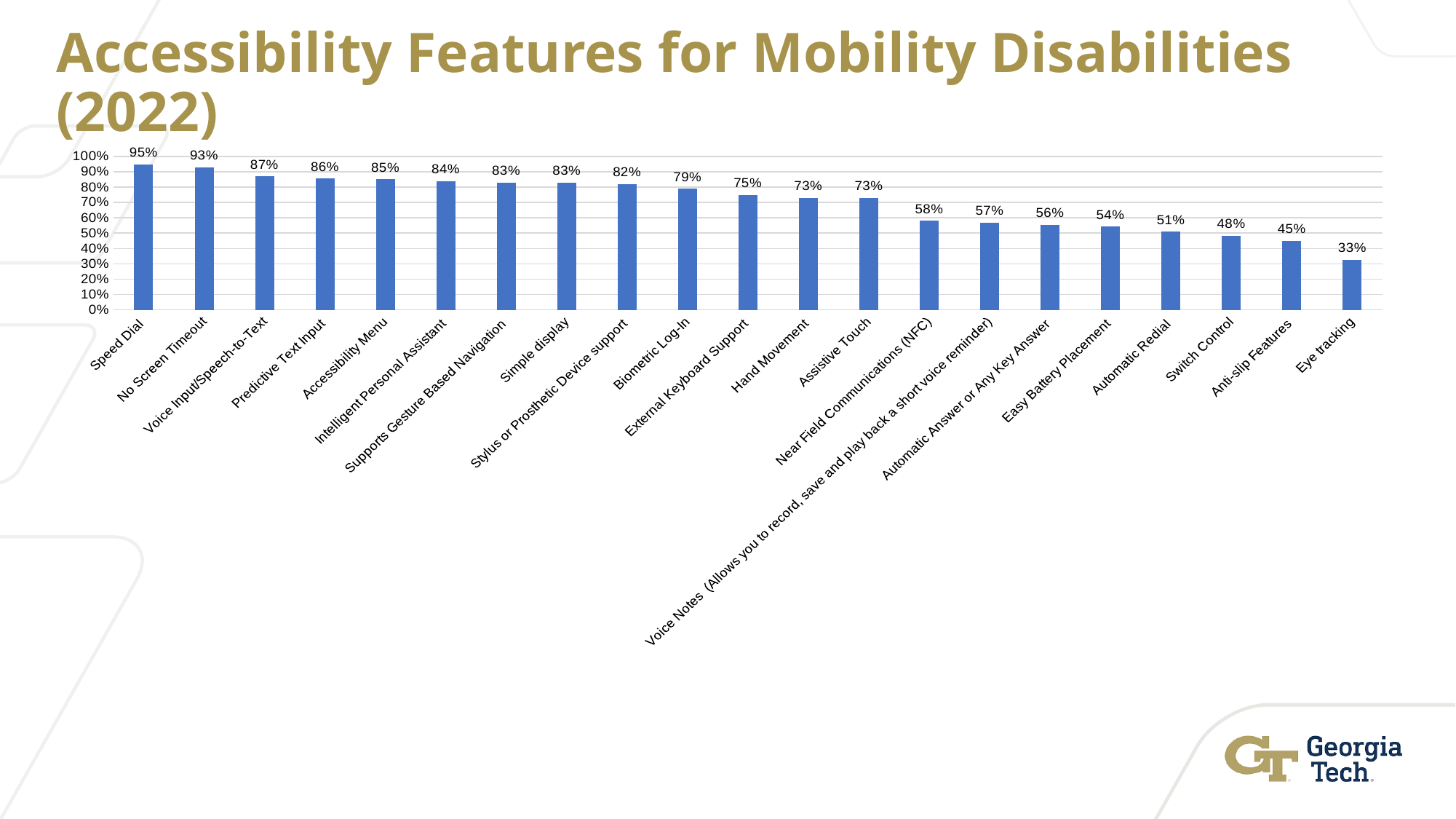
What kind of chart is shown on the slide? Bar chart What is the difference between the values for Speed Dial and Eye tracking? 62% What is the value for Biometric Log-In? 79% What is the difference between the values for External Keyboard Support and Automatic Redial? 24% What is the value for Speed Dial? 95% What is the value for Switch Control? 48% Which is larger, the value for Predictive Text Input or the value for Anti-slip Features? Predictive Text Input What is the value for Near Field Communications (NFC)? 58% Do the values rise or fall from left to right along the x axis? Fall How many features are shown in the chart? 21 Which feature has the lowest value? Eye tracking Which feature has the highest value? Speed Dial